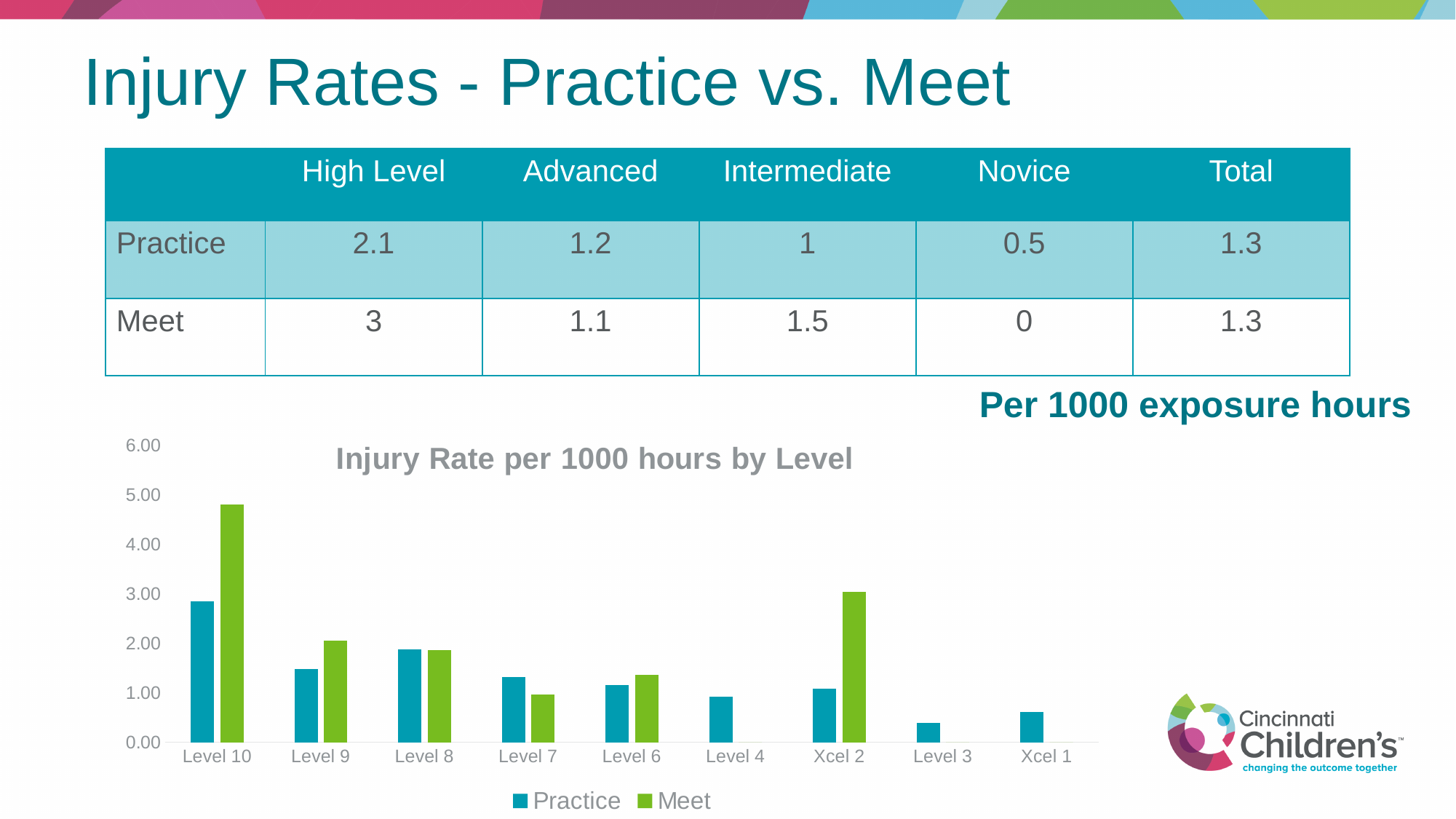
Is the Meet value for Xcel 2 greater or less than 2.00? greater Which level has the highest Meet injury rate in the chart? Level 10 Which level has the lowest Practice injury rate in the chart? Level 3 Is the Practice value for Level 9 greater or less than 1.00? greater For Level 7, which is larger, the Practice value or the Meet value? Practice What kind of chart is shown on the slide? bar chart What is the title of the chart on the slide? Injury Rate per 1000 hours by Level Is the Meet value for Level 10 greater or less than 4.00? greater How many level categories are shown on the x axis of the chart? 9 Which level has the highest Practice injury rate in the chart? Level 10 How many series does the chart's legend list? 2 For Xcel 2, which is larger, the Practice value or the Meet value? Meet